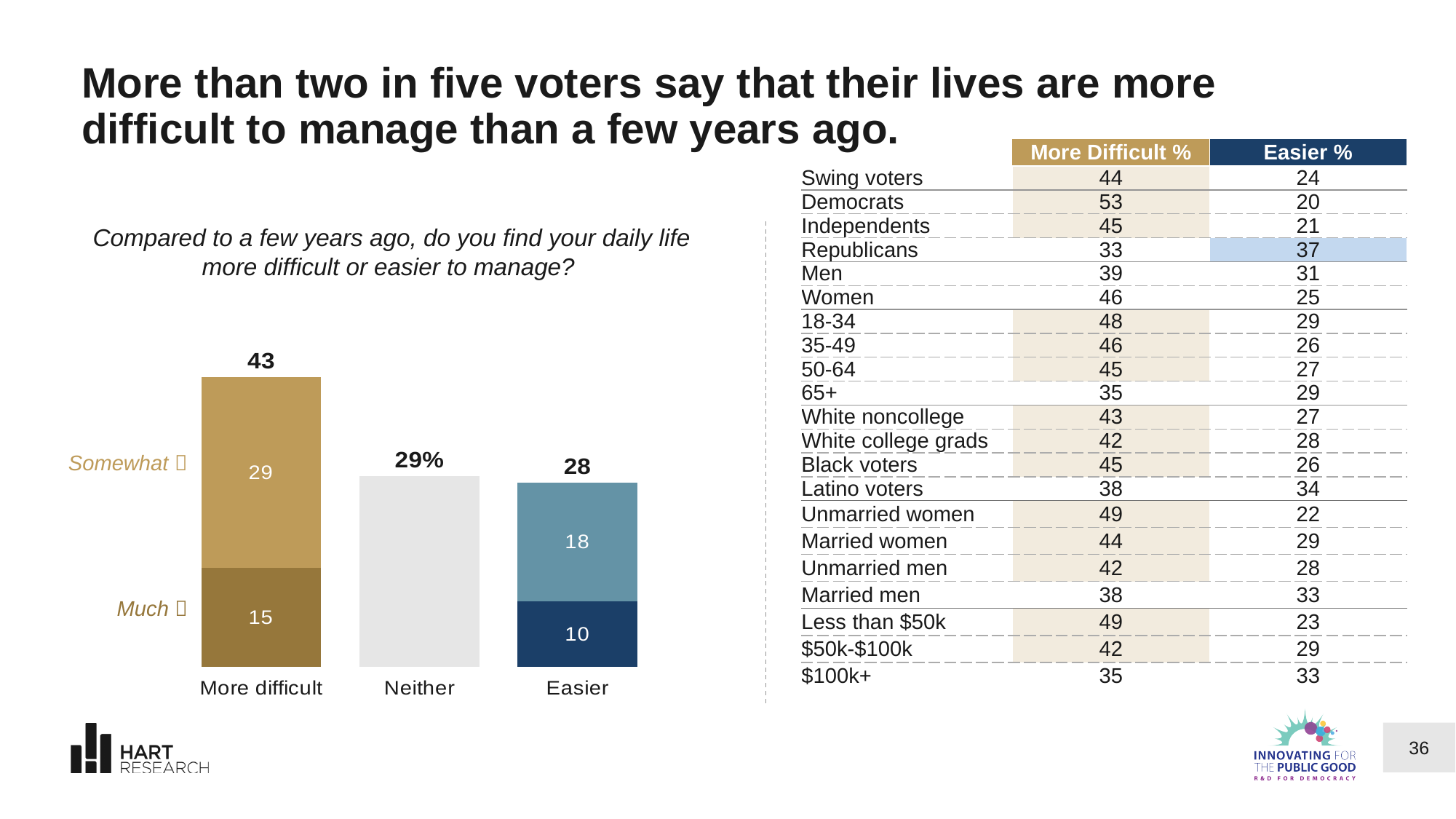
What is the "Much" portion of the "Easier" bar? 10 What is the difference between the total for "More difficult" and the total for "Easier"? 15 What is the "Much" portion of the "More difficult" bar? 15 What is the total value shown above the "Easier" bar? 28 Which category has the highest total value in the chart? More difficult Which is larger, the "Somewhat" portion of "More difficult" or the "Somewhat" portion of "Easier"? More difficult How many categories are shown on the x axis of the chart? 3 What is the "Somewhat" portion of the "Easier" bar? 18 What is the total value shown above the "More difficult" bar? 43 What kind of chart is shown on the slide? Bar chart Which category has the lowest total value in the chart? Easier What value is shown for the "Neither" bar? 29%